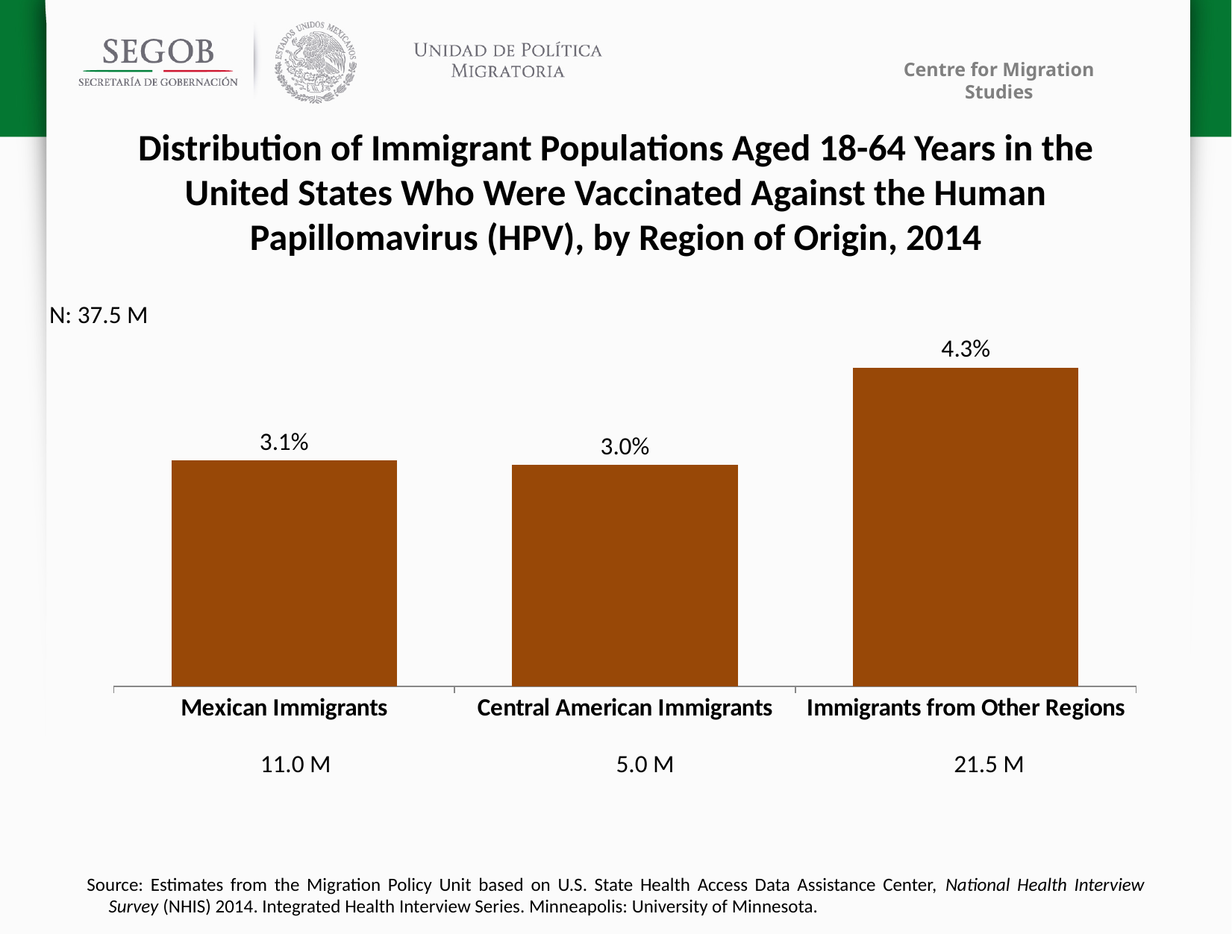
How many regions of origin are shown in the chart? 3 What is the difference in HPV vaccination percentage between Immigrants from Other Regions and Mexican Immigrants? 1.2% What percentage of Mexican Immigrants were vaccinated against HPV? 3.1% What percentage of Central American Immigrants were vaccinated against HPV? 3.0% What percentage of Immigrants from Other Regions were vaccinated against HPV? 4.3% What kind of chart is shown on the slide? Bar chart What is the population size (N) shown for Immigrants from Other Regions below the chart? 21.5 M What is the population size (N) shown for Mexican Immigrants below the chart? 11.0 M What is the difference in HPV vaccination percentage between Immigrants from Other Regions and Central American Immigrants? 1.3% Which has a larger HPV vaccination percentage: Mexican Immigrants or Immigrants from Other Regions? Immigrants from Other Regions What total N is shown for the chart? 37.5 M Which region of origin has the highest HPV vaccination percentage? Immigrants from Other Regions